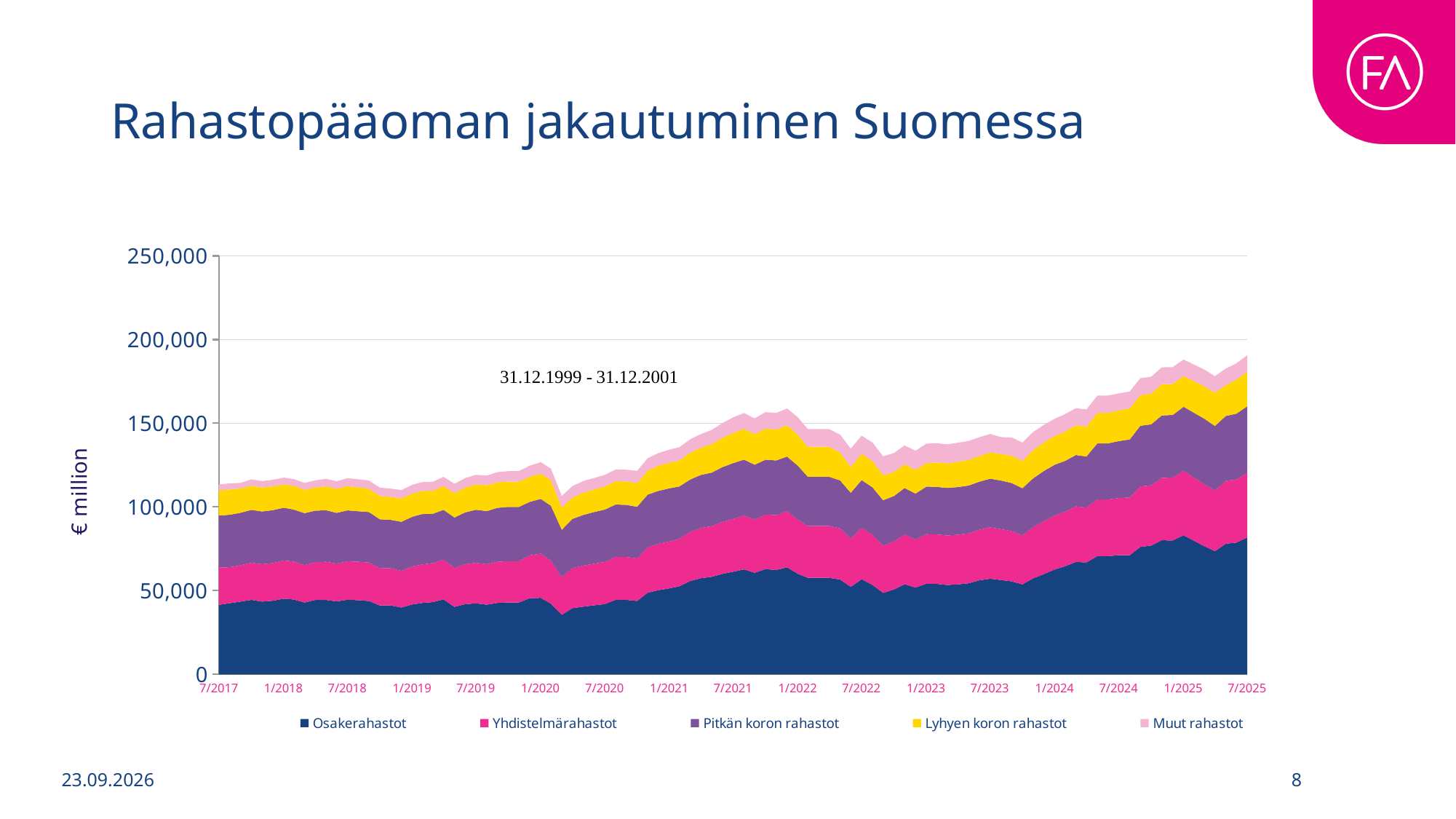
Is the value for Osakerahastot at 7/2017 greater or less than 50,000? less Which series has the largest value at 7/2025? Osakerahastot How many series does the legend list? 5 What unit is shown on the vertical axis label? € million What is the title of the chart? Rahastopääoman jakautuminen Suomessa What kind of chart is shown on the slide? Stacked area chart Is the value for Osakerahastot at 7/2025 greater or less than 50,000? greater Is the total value of all series at 7/2017 greater or less than 150,000? less How many date labels are shown on the x axis? 17 Which series has the smallest value at 7/2025? Muut rahastot Does the total fund capital rise or fall overall from 7/2017 to 7/2025? rise